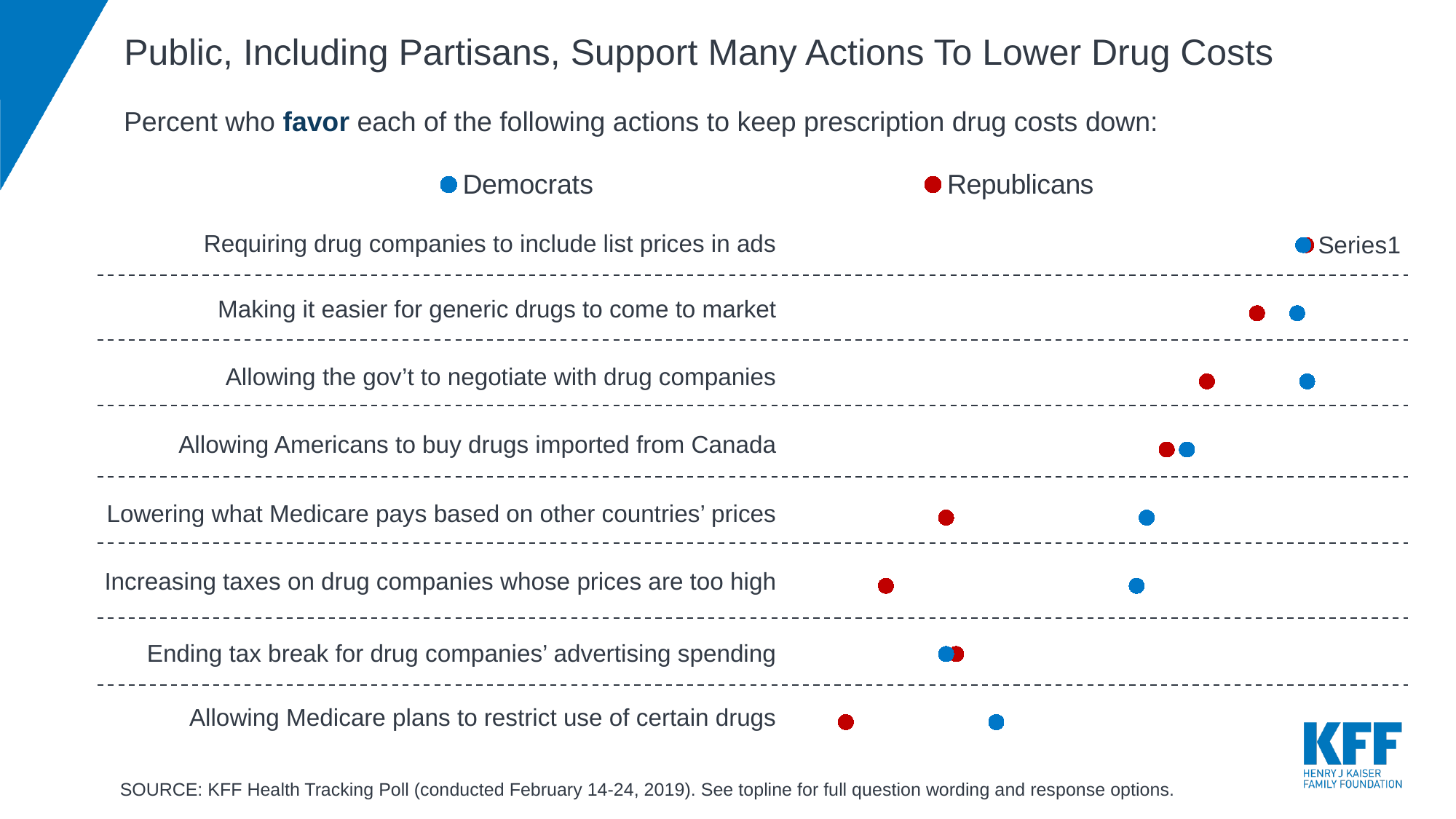
For 'Allowing the gov't to negotiate with drug companies', which group shows higher support, Democrats or Republicans? Democrats Which action has the lowest support among Democrats? Ending tax break for drug companies' advertising spending For 'Allowing Medicare plans to restrict use of certain drugs', which group shows higher support, Democrats or Republicans? Democrats How many series does the legend list? 2 Which two groups are shown in the legend? Democrats and Republicans How many actions (categories) are plotted on the chart? 8 For 'Increasing taxes on drug companies whose prices are too high', which group shows higher support, Democrats or Republicans? Democrats Which action has the lowest support among Republicans? Allowing Medicare plans to restrict use of certain drugs What kind of chart is shown on the slide? dot plot Which action has the highest support among Republicans? Requiring drug companies to include list prices in ads What colour marks the Republicans series? red